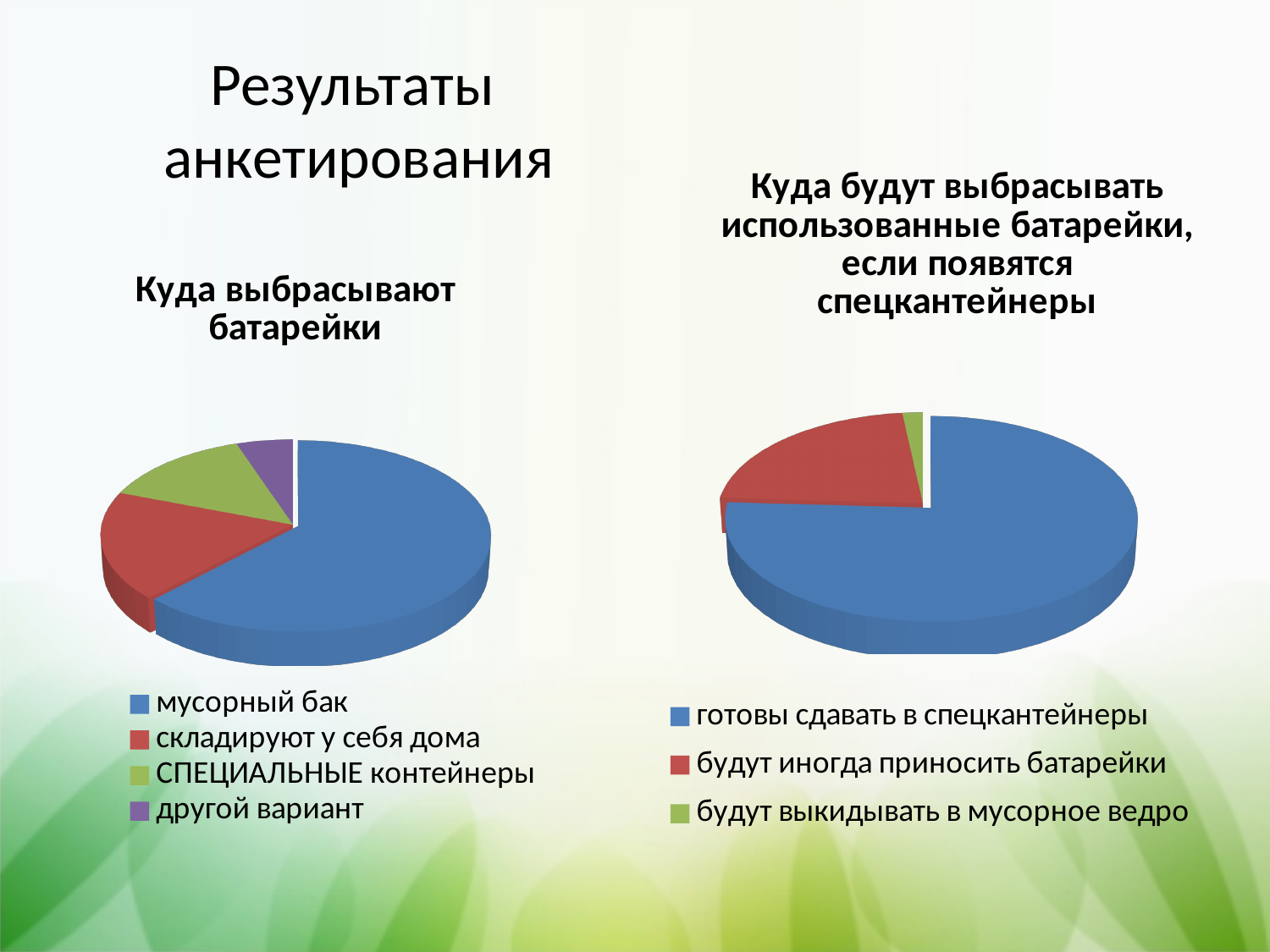
In the right chart, "Куда будут выбрасывать использованные батарейки, если появятся спецкантейнеры", which category has the smallest slice? будут выкидывать в мусорное ведро In the left chart, "Куда выбрасывают батарейки", what colour is the slice for "другой вариант"? purple What kind of chart is the right chart, "Куда будут выбрасывать использованные батарейки, если появятся спецкантейнеры"? pie chart In the left chart, "Куда выбрасывают батарейки", which slice is larger: "складируют у себя дома" or "СПЕЦИАЛЬНЫЕ контейнеры"? складируют у себя дома In the right chart, "Куда будут выбрасывать использованные батарейки, если появятся спецкантейнеры", which category has the largest slice? готовы сдавать в спецкантейнеры In the left chart, "Куда выбрасывают батарейки", which category has the smallest slice? другой вариант What kind of chart is the left chart, "Куда выбрасывают батарейки"? pie chart In the right chart, "Куда будут выбрасывать использованные батарейки, если появятся спецкантейнеры", how many slices does the pie have? 3 How many entries does the legend of the right chart, "Куда будут выбрасывать использованные батарейки, если появятся спецкантейнеры", list? 3 In the right chart, "Куда будут выбрасывать использованные батарейки, если появятся спецкантейнеры", which slice is larger: "будут иногда приносить батарейки" or "будут выкидывать в мусорное ведро"? будут иногда приносить батарейки In the left chart, "Куда выбрасывают батарейки", which category has the largest slice? мусорный бак In the left chart, "Куда выбрасывают батарейки", how many slices does the pie have? 4